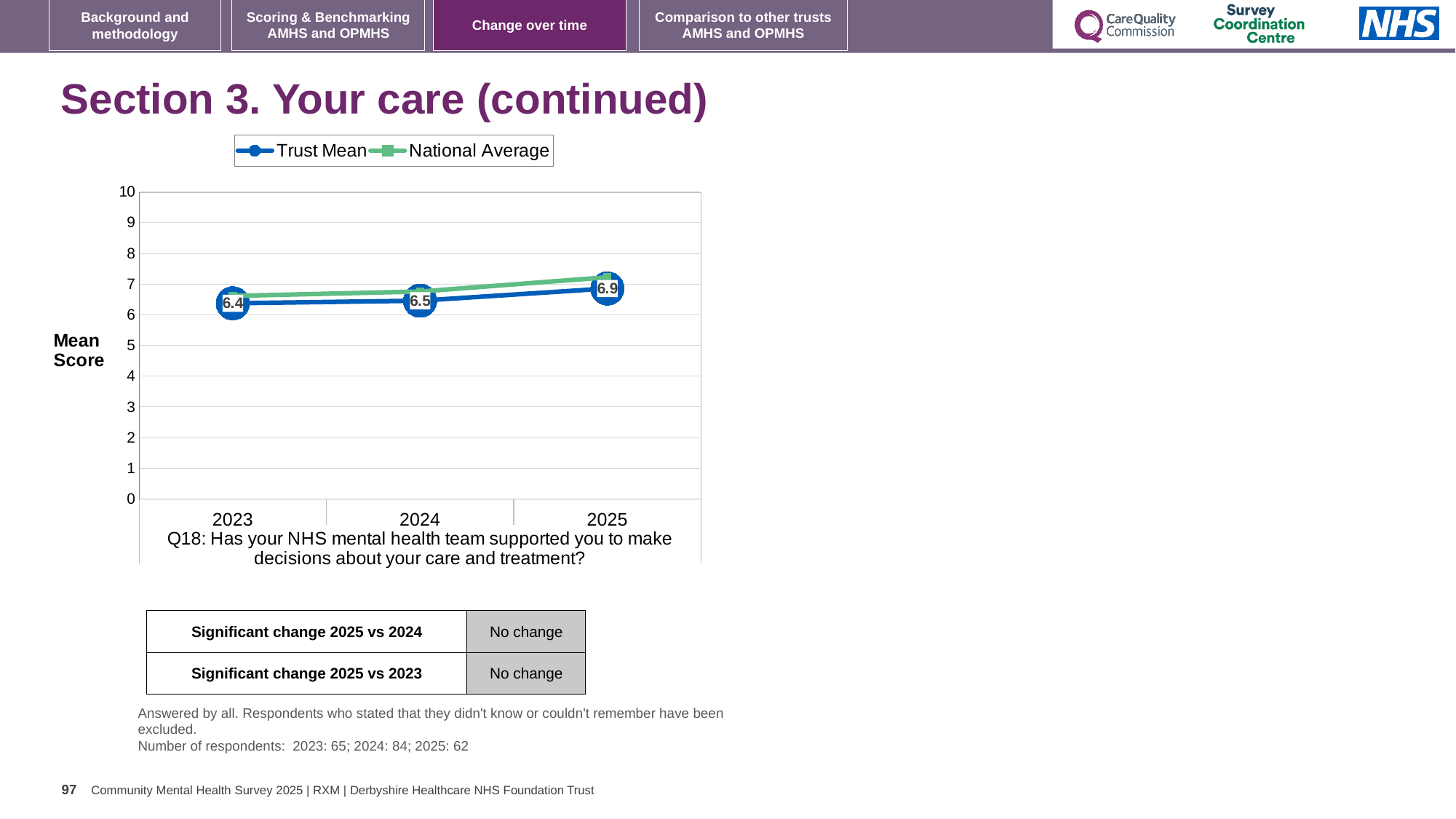
What is the Trust Mean score for 2025? 6.9 Is the National Average value for 2023 greater or less than 8? less Does the Trust Mean score rise or fall from 2023 to 2025? Rise What is the Trust Mean score for 2023? 6.4 What is the difference between the Trust Mean score in 2025 and in 2023? 0.5 Is the National Average value for 2025 greater or less than 6? greater How many years are plotted on the x axis? 3 What kind of chart is shown on the slide? Line chart How many series does the legend list? 2 In which year is the Trust Mean score lowest? 2023 In which year is the Trust Mean score highest? 2025 In 2025, which series has the higher value, Trust Mean or National Average? National Average